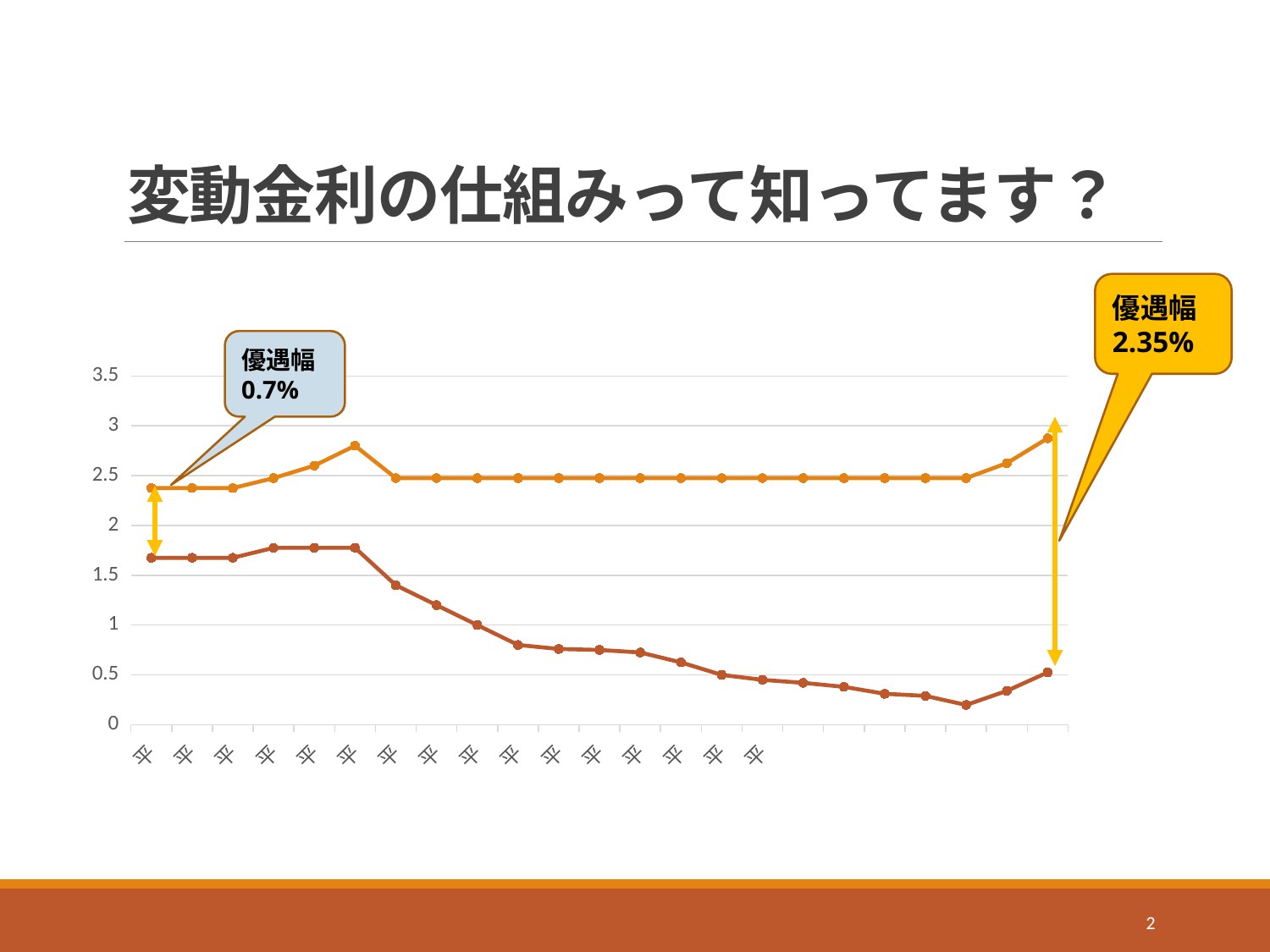
Is the value of the upper (orange) line at its first point greater or less than 2? greater Is the value of the lower (brown) line at its first point greater or less than 1.5? greater Is the highest point of the upper (orange) line greater or less than 2.5? greater What kind of chart is shown on the slide? line chart What 優遇幅 (preferential margin) value is shown in the callout at the left of the chart? 0.7% At the last data point, which line has the larger value, the upper orange line or the lower brown line? the upper orange line How many data points does each line on the chart have? 23 Does the lower (brown) line overall rise or fall from left to right? fall How many lines (series) are plotted on the chart? 2 What 優遇幅 (preferential margin) value is shown in the callout at the right of the chart? 2.35%